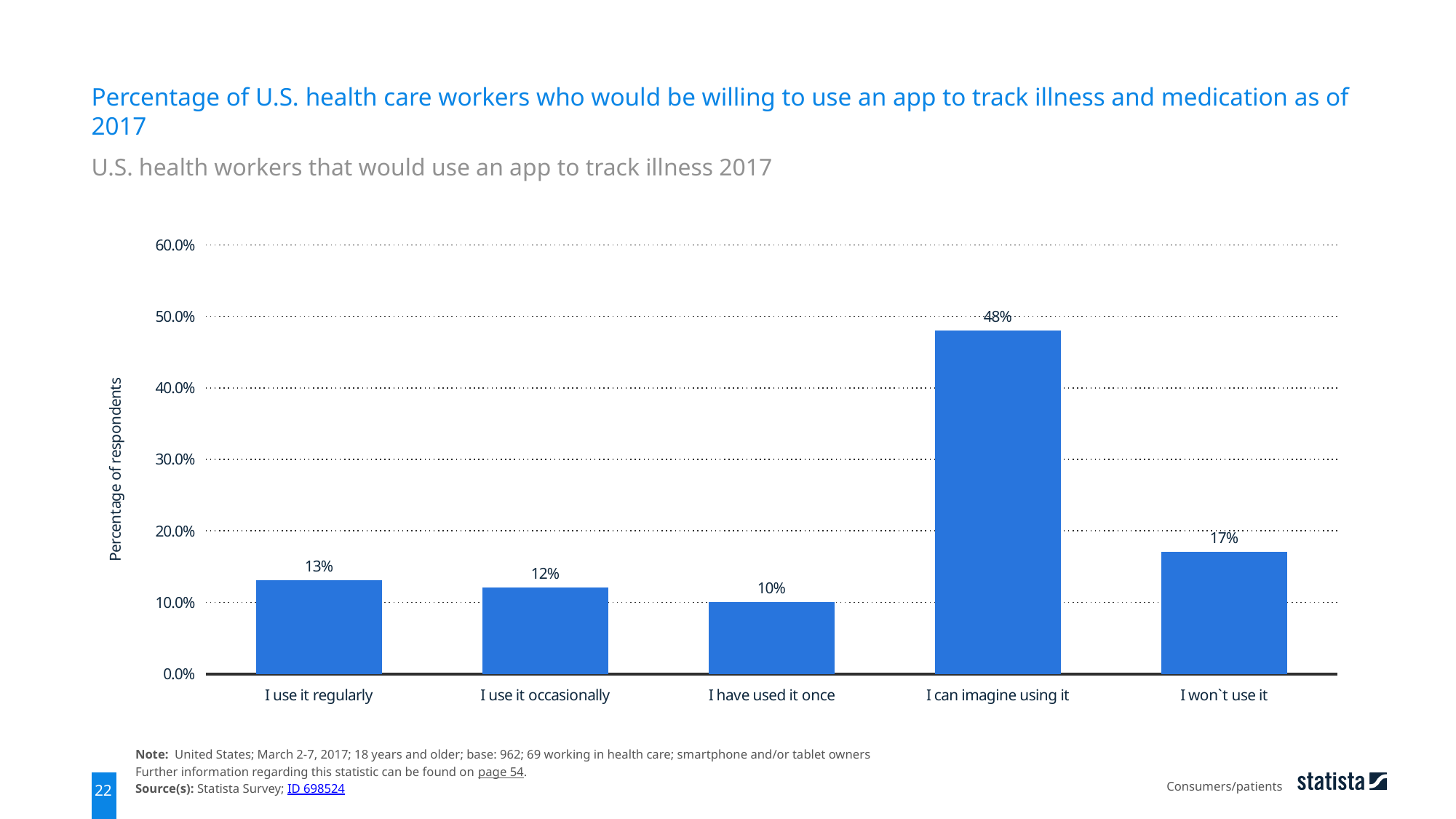
Is the value for "I can imagine using it" greater or less than 40.0%? greater What is the value for "I use it regularly"? 13% Which category has the highest value? I can imagine using it Which category has the lowest value? I have used it once What kind of chart is shown on the slide? Bar chart What is the difference between "I use it regularly" and "I have used it once"? 3% What is the value for "I won`t use it"? 17% What is the difference between "I can imagine using it" and "I won`t use it"? 31% What percentage of respondents said "I can imagine using it"? 48% How many categories are shown on the x axis? 5 What is the label of the y axis? Percentage of respondents Which is larger, "I use it occasionally" or "I won`t use it"? I won`t use it